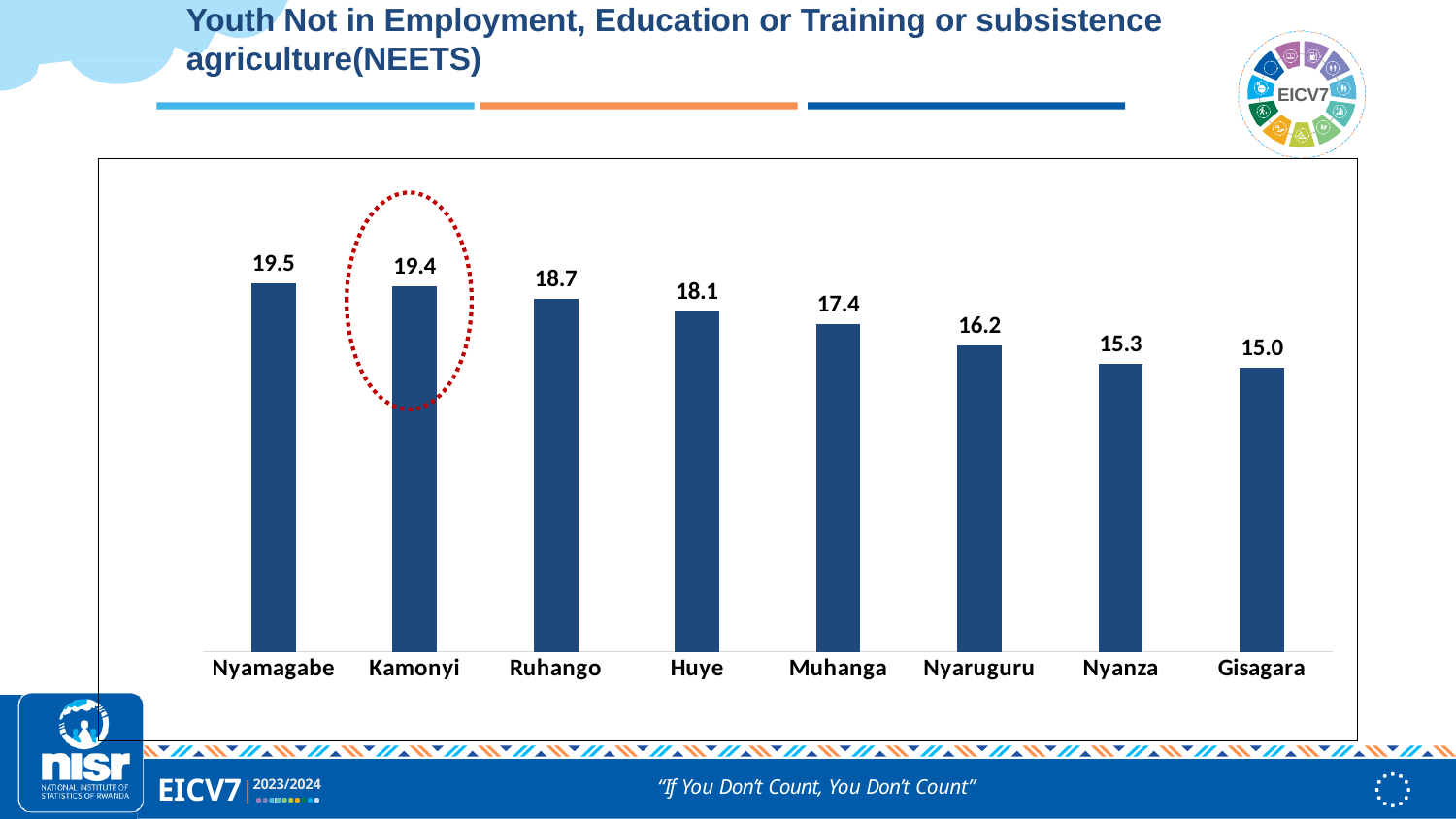
What is the difference between the values for Nyamagabe and Gisagara? 4.5 Which district's bar is circled with a red dotted line? Kamonyi Do the values rise or fall from left to right along the x axis? Fall Which district has the lowest value? Gisagara What is the value for Gisagara? 15.0 What is the difference between the values for Ruhango and Nyaruguru? 2.5 What is the value for Kamonyi? 19.4 What is the value for Muhanga? 17.4 Which is larger, the value for Huye or the value for Nyanza? Huye How many districts are shown in the chart? 8 What kind of chart is shown on the slide? Bar chart Which district has the highest value? Nyamagabe